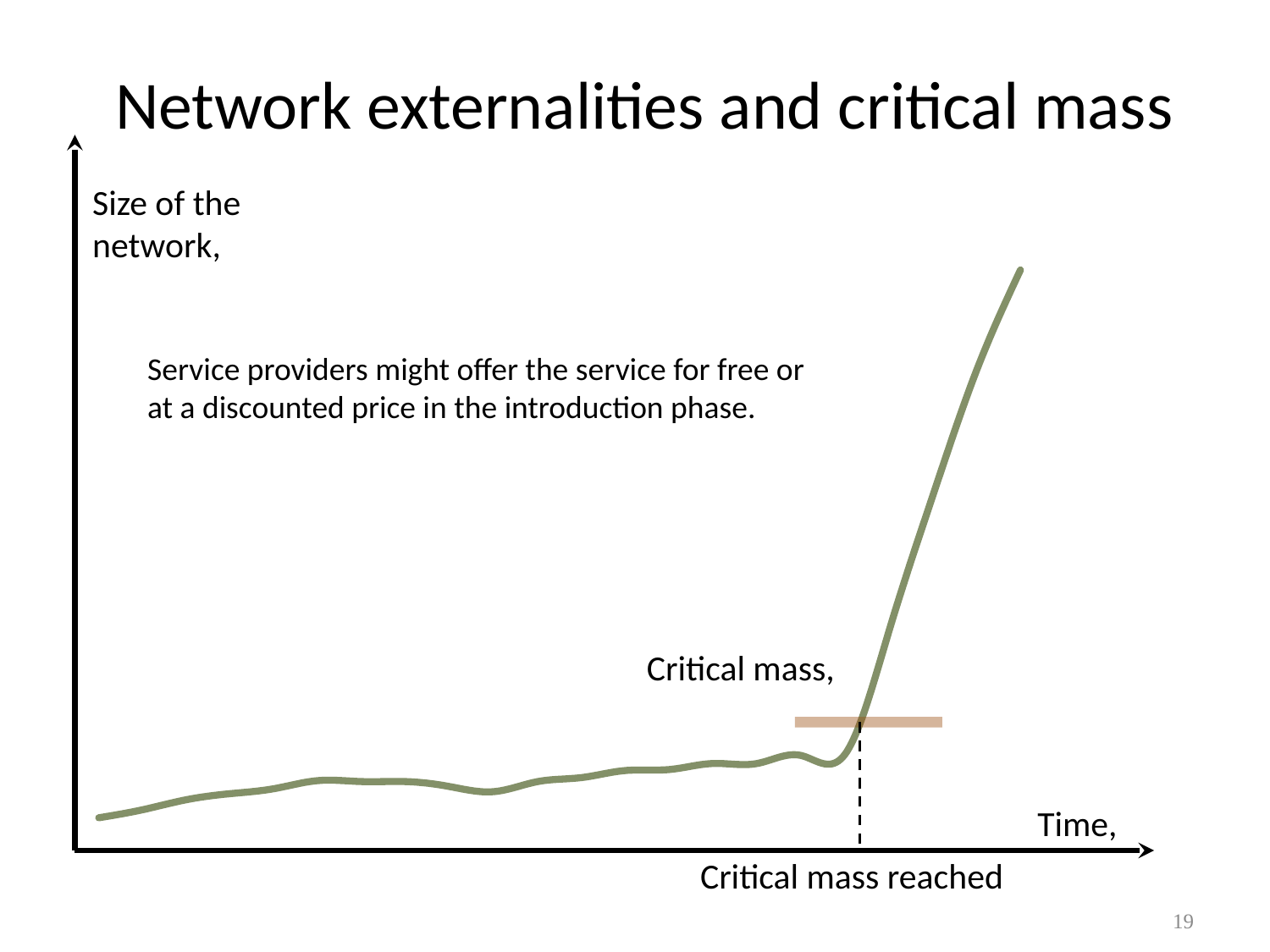
How many plotted lines (series) does the chart show? 1 Does the size of the network rise or fall as time increases along the x axis? Rise Is the size of the network at the start of the time axis greater or less than the critical mass level? Less Does the curve rise more steeply before or after the point where critical mass is reached? After Is the size of the network at the end of the time axis greater or less than the critical mass level? Greater What kind of chart is shown on the slide? Line chart What is the label of the vertical axis of the chart? Size of the network, What is the label of the horizontal axis of the chart? Time,